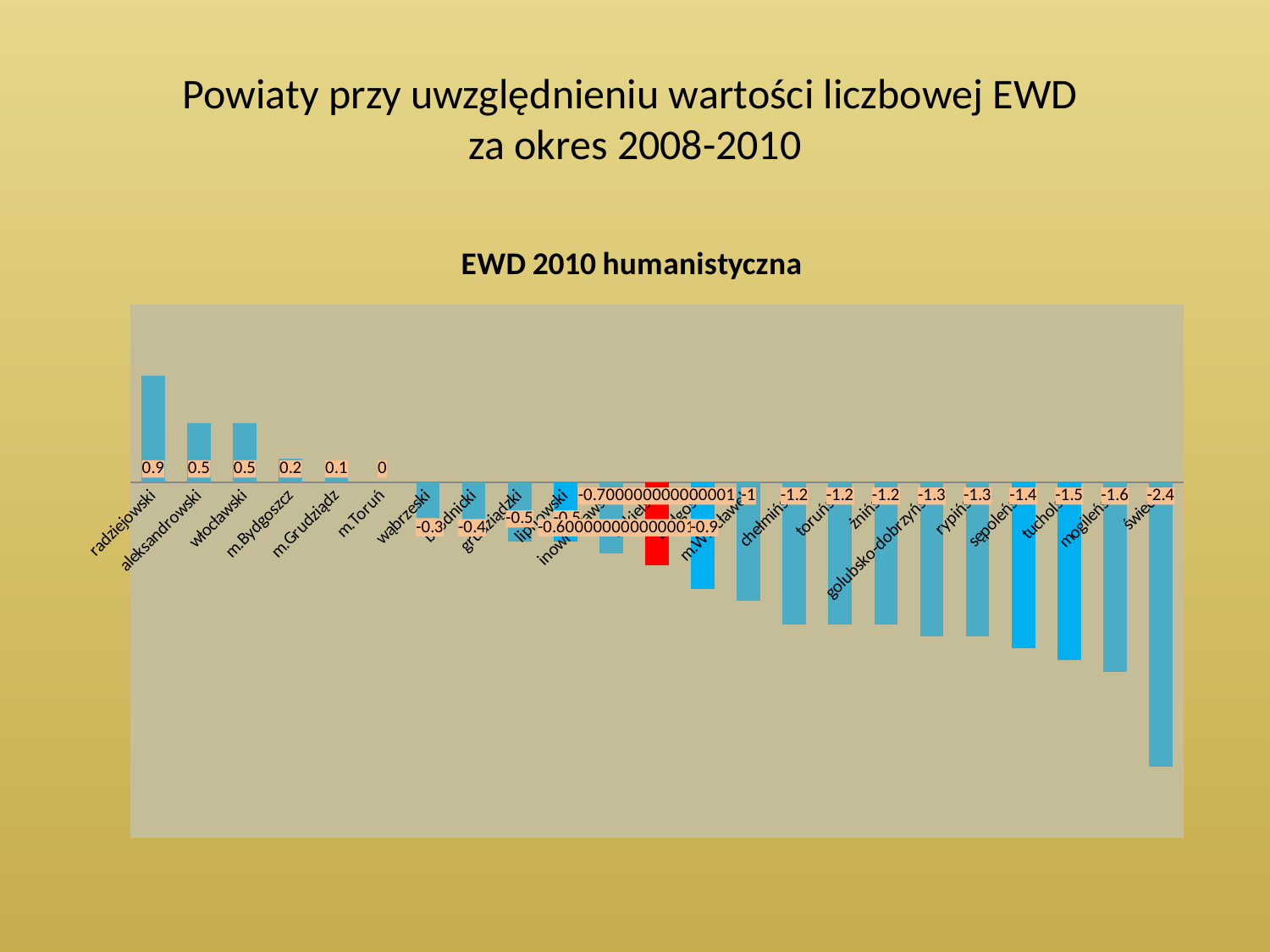
Do the values rise or fall from left to right along the x axis? fall What is the value for wąbrzeski? -0.3 What is the value for m.Bydgoszcz? 0.2 Which category has the lowest value? świecki Which category has the highest value? radziejowski What kind of chart is shown? bar chart What is the value for radziejowski? 0.9 What is the difference between the values for radziejowski and aleksandrowski? 0.4 Which is larger, the value for chełmiński or the value for sępoleński? chełmiński What is the value for tucholski? -1.5 What is the title of the chart? EWD 2010 humanistyczna What is the value for m.Toruń? 0